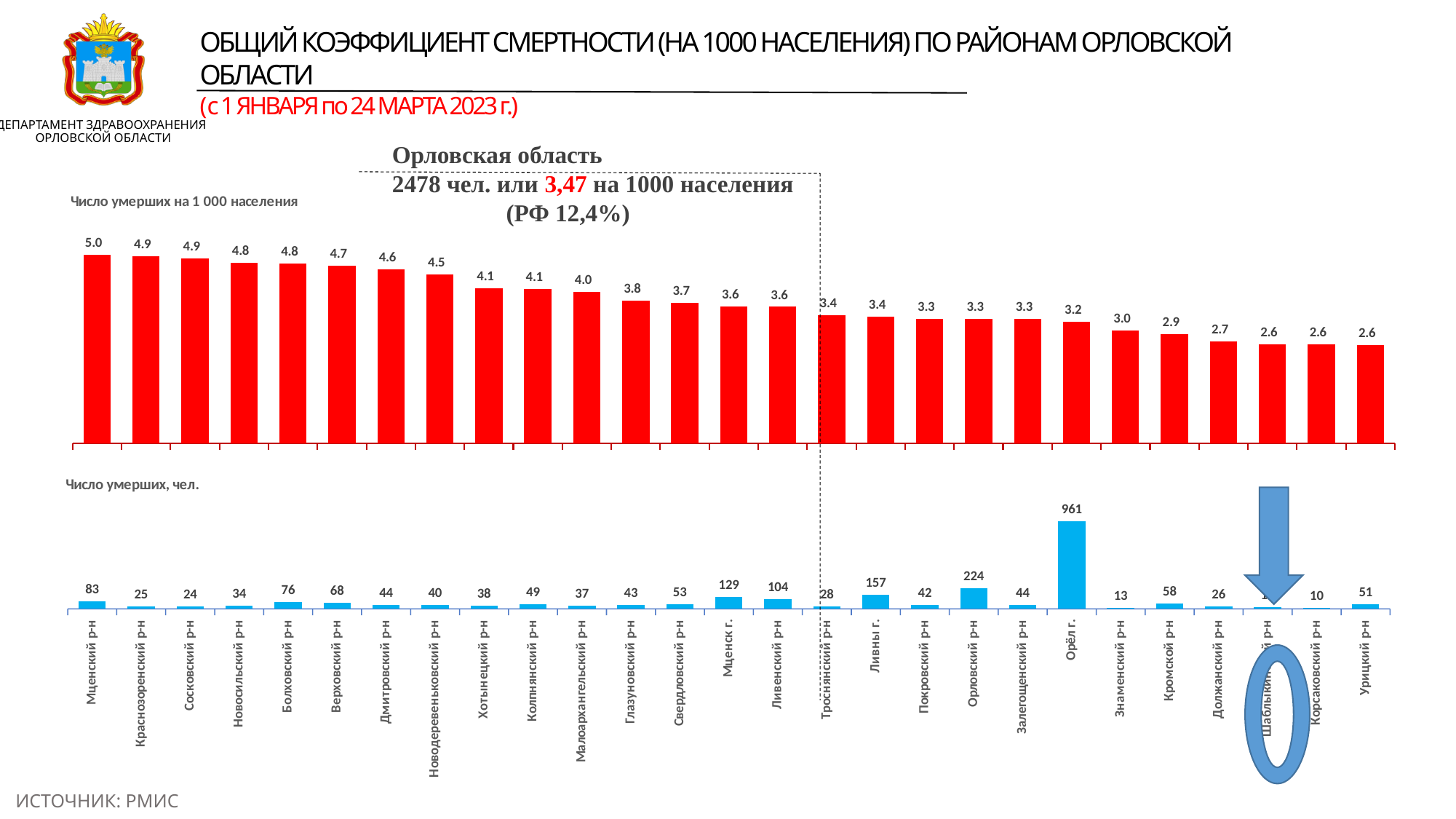
In the top chart (Число умерших на 1 000 населения), what is the value for Мценский р-н? 5.0 What type of chart is the top chart (Число умерших на 1 000 населения)? bar chart In the top chart (Число умерших на 1 000 населения), what is the value for Троснянский р-н? 3.4 In the bottom chart (Число умерших, чел.), what is the value for Ливны г.? 157 In the top chart (Число умерших на 1 000 населения), do the values rise or fall from left to right? fall In the top chart (Число умерших на 1 000 населения), which district has the highest value? Мценский р-н In the top chart (Число умерших на 1 000 населения), what is the difference between Мценский р-н and Кромской р-н? 2.1 In the bottom chart (Число умерших, чел.), what is the value for Орёл г.? 961 In the bottom chart (Число умерших, чел.), which category has the highest value? Орёл г. How many districts/cities are shown on the x axis of the top chart? 27 In the bottom chart (Число умерших, чел.), what is the difference between Орловский р-н and Ливенский р-н? 120 In the top chart (Число умерших на 1 000 населения), which is larger: Болховский р-н or Глазуновский р-н? Болховский р-н